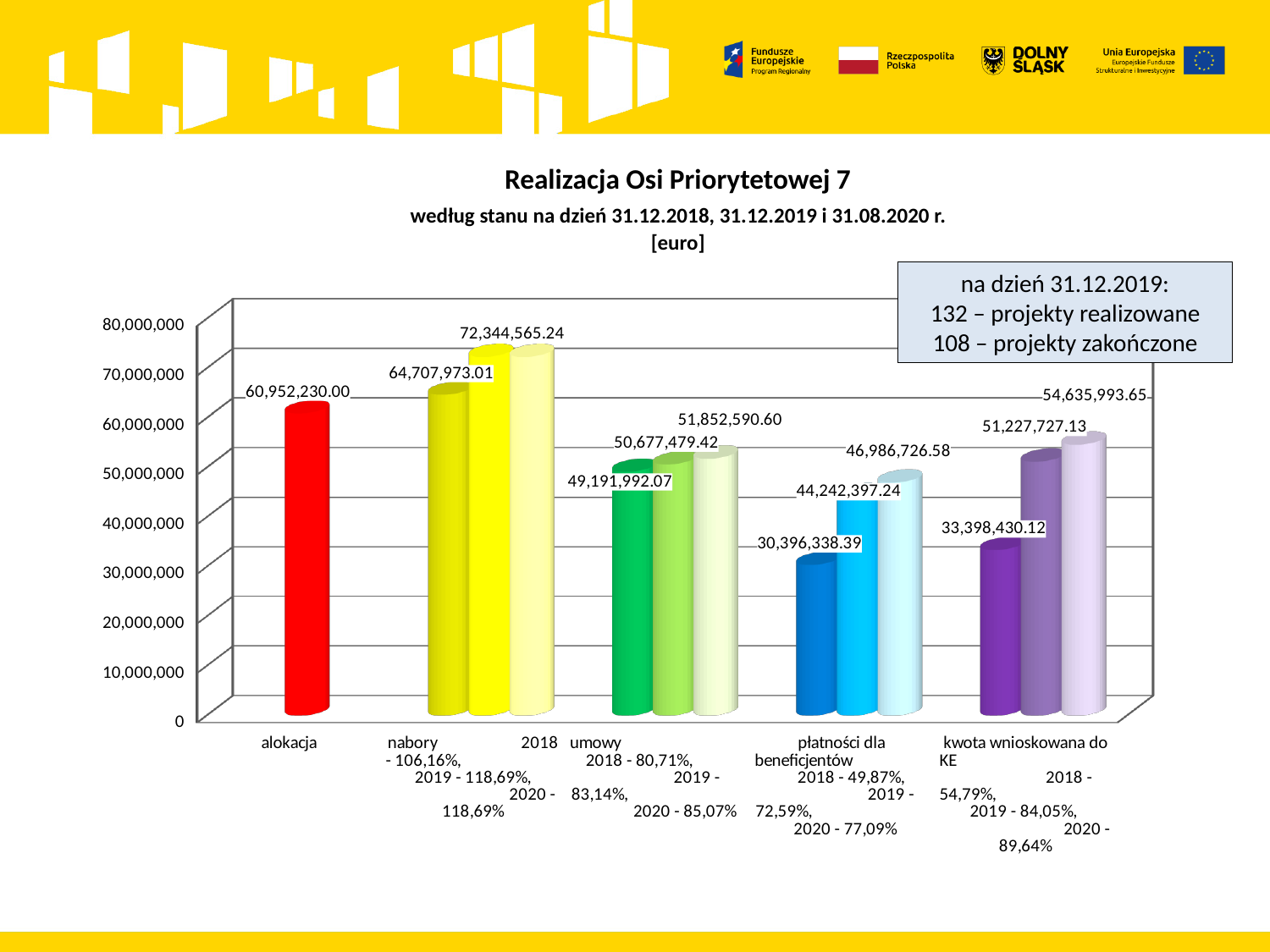
Which is larger: the alokacja bar (60,952,230.00) or the first nabory bar (64,707,973.01)? the first nabory bar (64,707,973.01) Is the lowest bar for kwota wnioskowana do KE greater or less than 40,000,000? less What is the lowest value labelled on the chart? 30,396,338.39 How many category groups are shown along the x axis? 5 What is the difference between the two highest labelled values for płatności dla beneficjentów, 46,986,726.58 and 44,242,397.24? 2,744,329.34 What is the value of the alokacja bar? 60,952,230.00 What is the highest value labelled on the chart? 72,344,565.24 What is the lowest labelled value among the płatności dla beneficjentów bars? 30,396,338.39 Do the labelled values for umowy rise or fall from the first bar to the third bar? rise What is the highest labelled value among the umowy bars? 51,852,590.60 What is the difference between the two highest labelled values for kwota wnioskowana do KE, 54,635,993.65 and 51,227,727.13? 3,408,266.52 What kind of chart is shown on the slide? bar chart